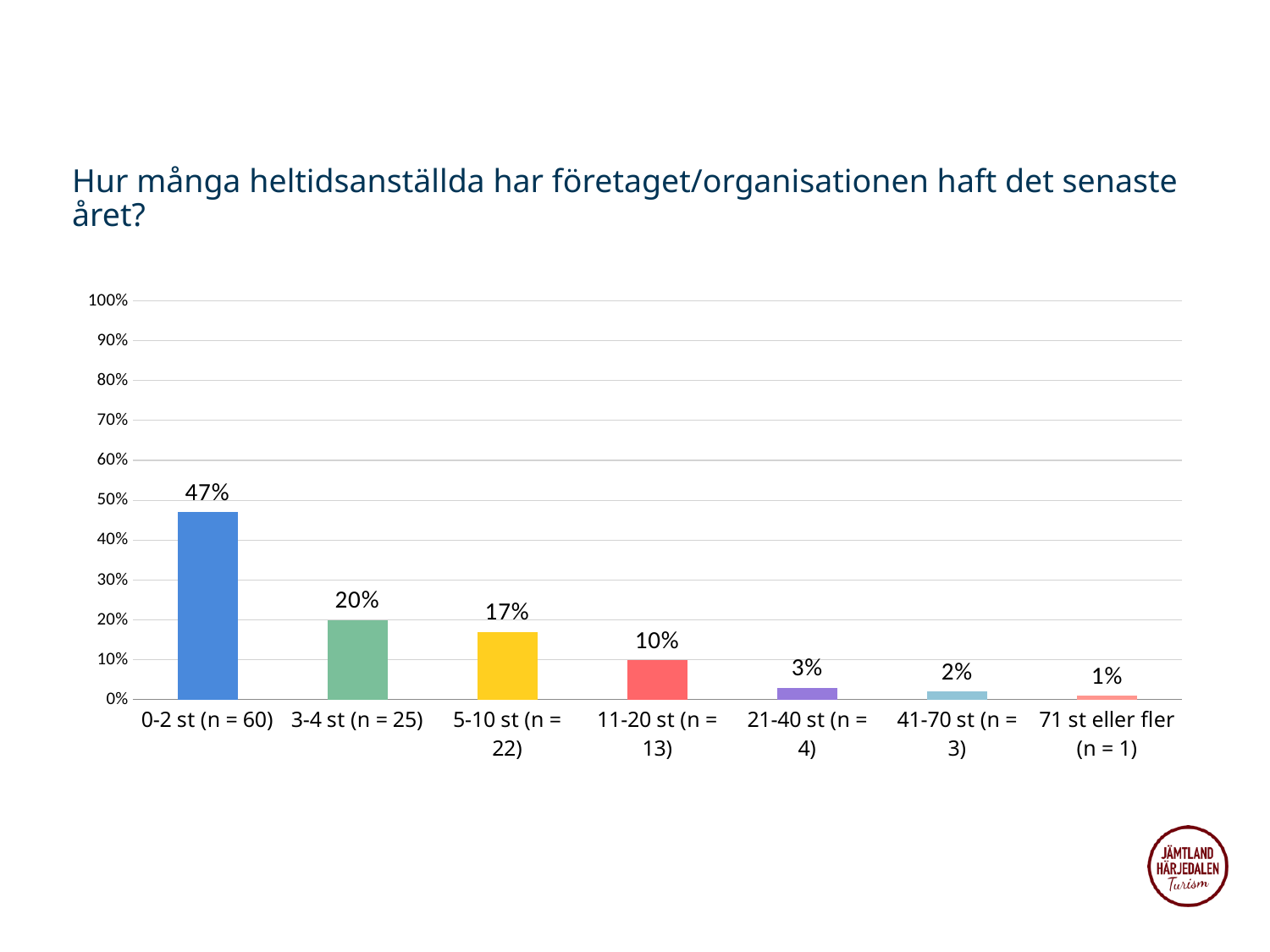
What is the value for the category "21-40 st (n = 4)"? 3% Which category has the lowest value? 71 st eller fler (n = 1) Do the values rise or fall from left to right along the x axis? fall How many categories are shown on the x axis? 7 Which category has the highest value? 0-2 st (n = 60) What is the difference between the values for "3-4 st (n = 25)" and "11-20 st (n = 13)"? 10% What is the difference between the values for "0-2 st (n = 60)" and "3-4 st (n = 25)"? 27% What is the value for the category "0-2 st (n = 60)"? 47% Which is larger, the value for "3-4 st (n = 25)" or the value for "5-10 st (n = 22)"? 3-4 st (n = 25) What is the value for the category "5-10 st (n = 22)"? 17% What kind of chart is shown on the slide? bar chart Is the value for "0-2 st (n = 60)" greater or less than 40%? greater